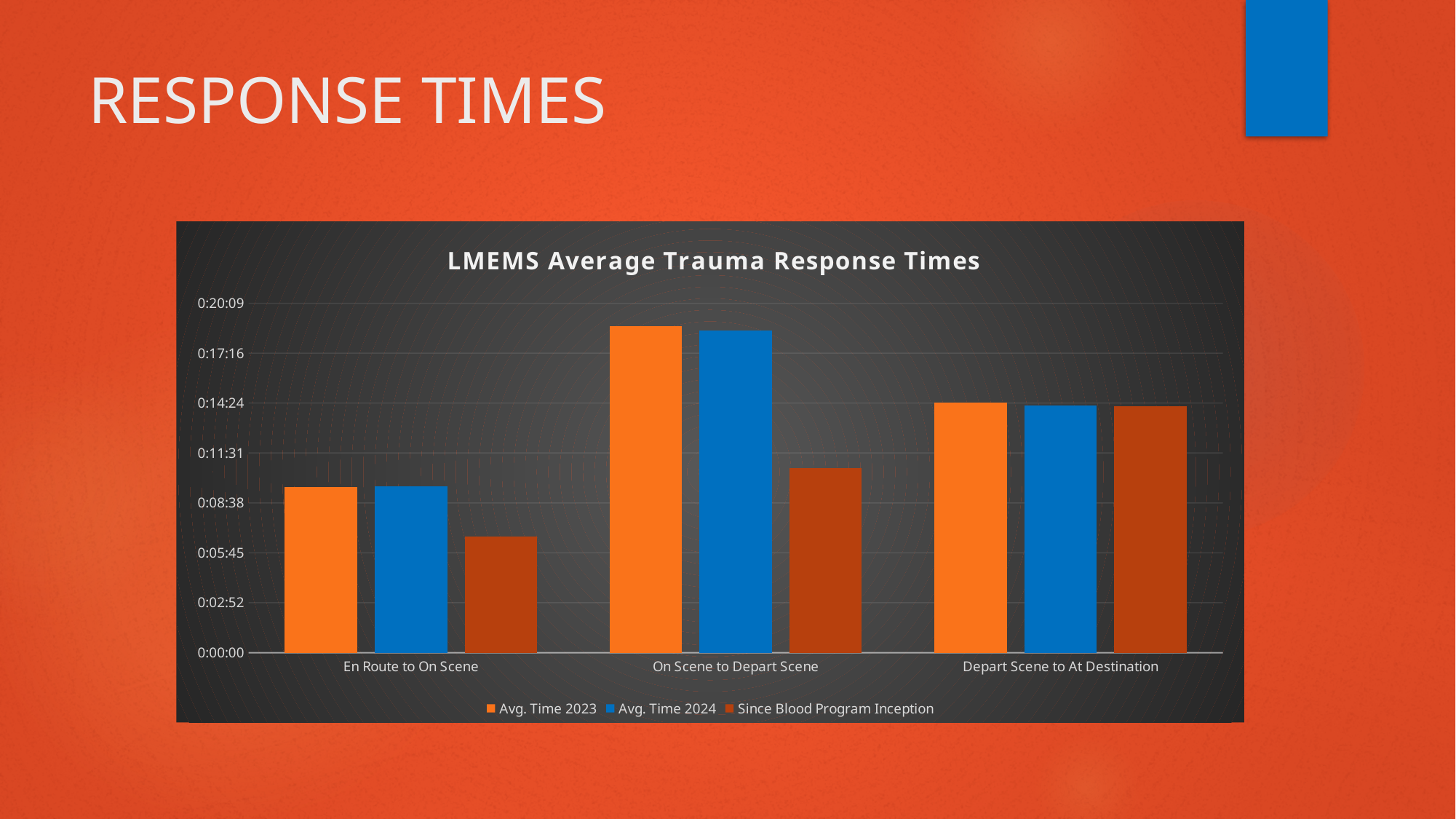
For En Route to On Scene, which is larger: Avg. Time 2023 or Since Blood Program Inception? Avg. Time 2023 For On Scene to Depart Scene, which is larger: Avg. Time 2024 or Since Blood Program Inception? Avg. Time 2024 Is the Avg. Time 2024 value for On Scene to Depart Scene greater or less than 0:17:16? greater Is the Since Blood Program Inception value for En Route to On Scene greater or less than 0:08:38? less How many series does the legend list? 3 What kind of chart is shown on the slide? bar chart Which category has the lowest Avg. Time 2024 value? En Route to On Scene What is the title of the chart? LMEMS Average Trauma Response Times How many categories are shown on the x axis? 3 Which category has the lowest Since Blood Program Inception value? En Route to On Scene Which colour represents the Avg. Time 2024 series in the legend? blue Which category has the highest Avg. Time 2023 value? On Scene to Depart Scene